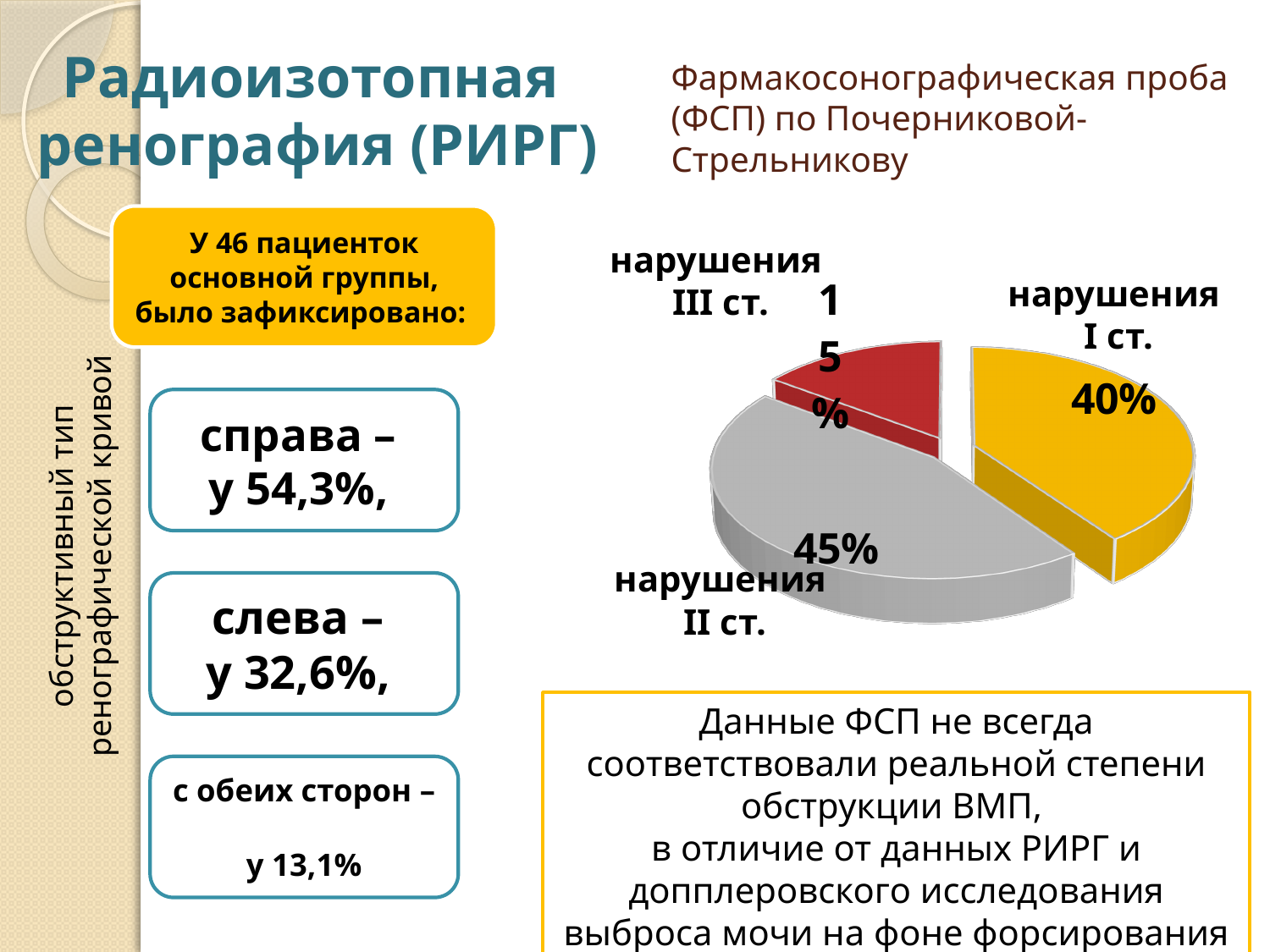
Which slice of the pie chart is the largest? нарушения II ст. What share of the pie is labelled "нарушения I ст."? 40% Which slice of the pie chart is the smallest? нарушения III ст. What share of the pie is labelled "нарушения II ст."? 45% How many slices does the pie chart have? 3 What kind of chart is shown on the slide? pie chart What colour is the "нарушения I ст." slice of the pie chart? yellow What share of the pie is labelled "нарушения III ст."? 15% What is the difference in percentage points between the "нарушения I ст." and "нарушения III ст." slices? 25 What colour is the "нарушения III ст." slice of the pie chart? red What is the difference in percentage points between the "нарушения II ст." and "нарушения I ст." slices? 5 Which is larger: the "нарушения I ст." slice or the "нарушения III ст." slice? нарушения I ст.